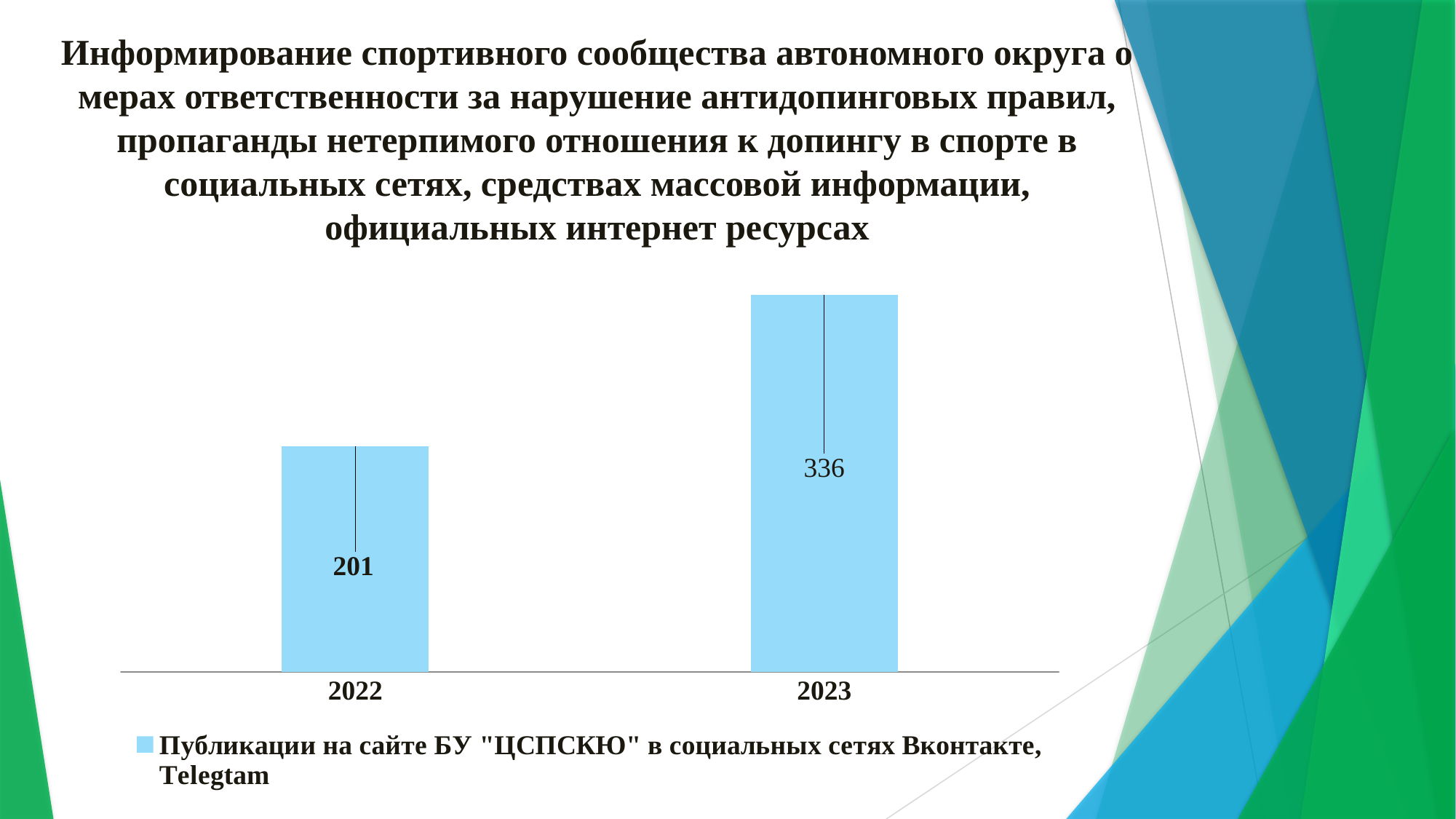
What is the value for 2023? 336 How many categories are shown on the x axis? 2 Which is larger, the value for 2022 or the value for 2023? 2023 What is the legend entry for the series? Публикации на сайте БУ "ЦСПСКЮ" в социальных сетях Вконтакте, Telegtam What kind of chart is shown on the slide? bar chart What is the value for 2022? 201 How many series does the legend list? 1 Do the values rise or fall from 2022 to 2023? rise Which year has the lowest value? 2022 What is the difference between the values for 2023 and 2022? 135 Which year has the highest value? 2023 What colour are the bars in the chart? light blue